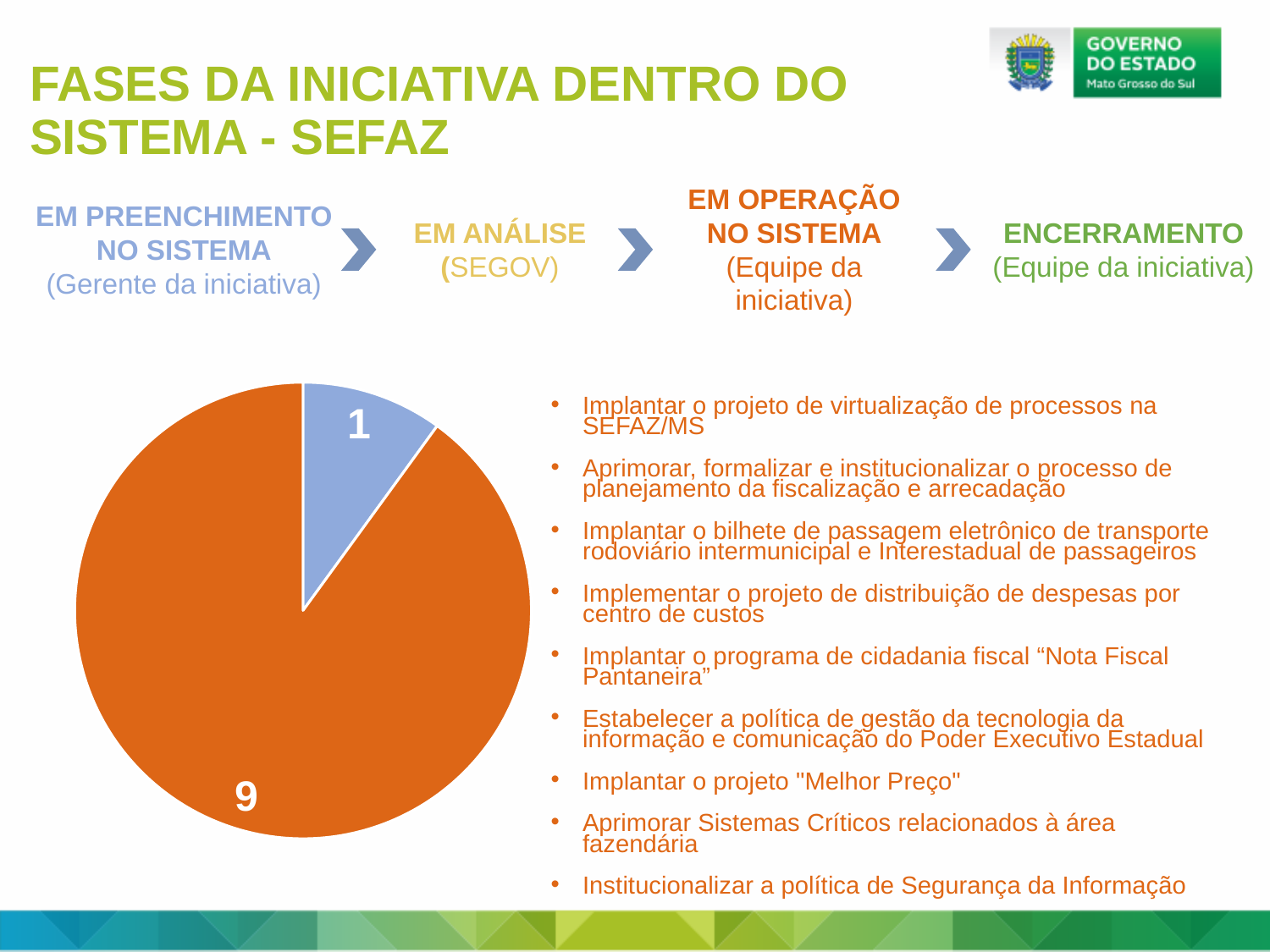
What share of the pie chart does the orange slice represent? 90% What is the difference between the orange slice value and the blue slice value in the pie chart? 8 Which slice of the pie chart is the largest? the orange slice (9) What share of the pie chart does the blue slice represent? 10% How many slices does the pie chart have? 2 What kind of chart is shown on the slide? pie chart Which slice of the pie chart is the smallest? the blue slice (1) Does the pie chart display a legend? No What is the total of the values shown in the pie chart? 10 What value is shown on the orange slice of the pie chart? 9 What value is shown on the blue slice of the pie chart? 1 Which is larger in the pie chart, the orange slice or the blue slice? the orange slice